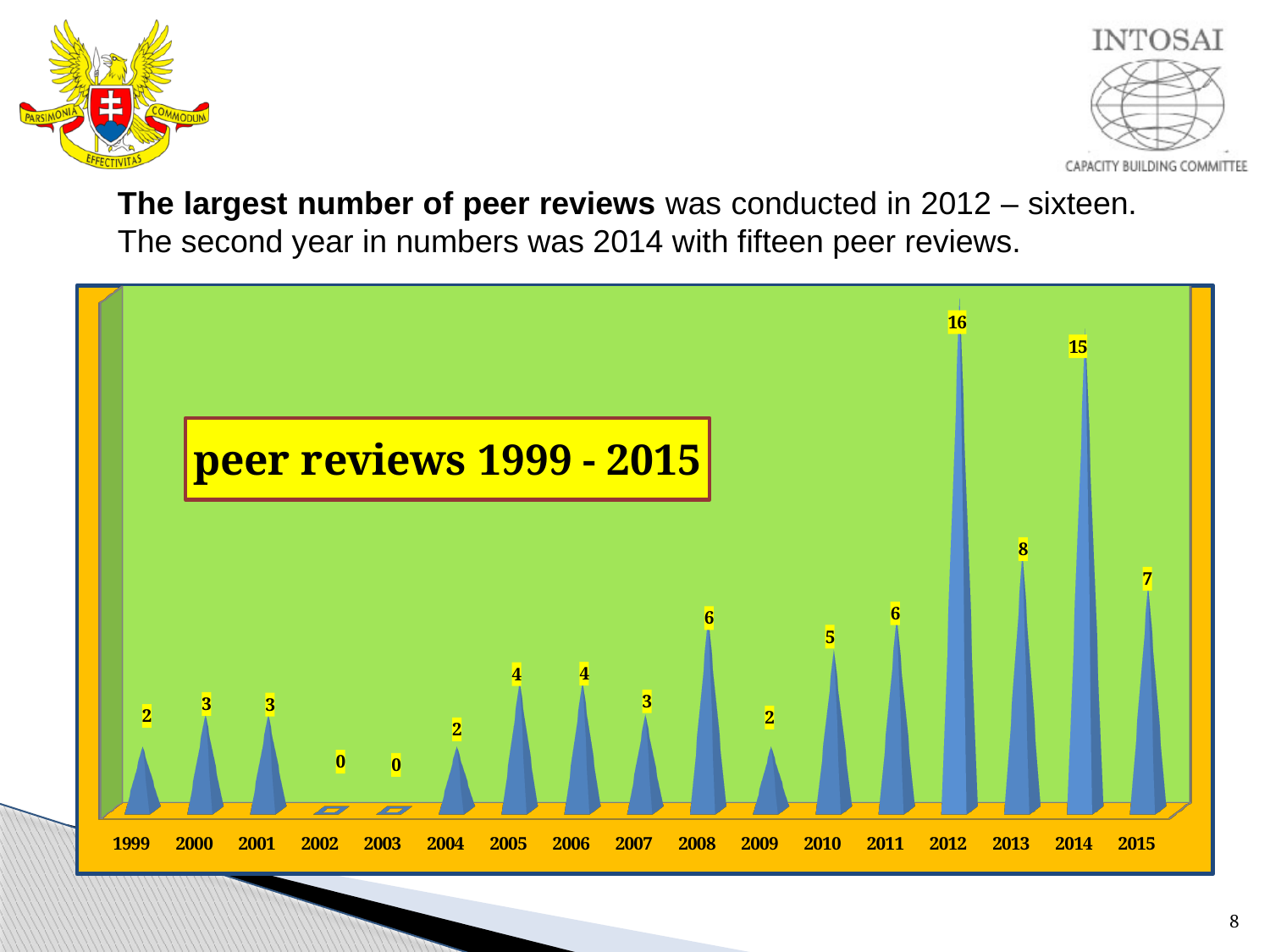
Which year had more peer reviews, 2010 or 2011? 2011 How many peer reviews were conducted in 2002? 0 What is the difference between the number of peer reviews in 2013 and 2015? 1 How many years are shown on the x axis of the chart? 17 Which year had more peer reviews, 2005 or 2009? 2005 How many peer reviews were conducted in 2008? 6 Which year has the highest number of peer reviews? 2012 How many peer reviews were conducted in 2001? 3 What kind of chart is shown on the slide? bar chart What is the difference between the number of peer reviews in 2012 and 2014? 1 How many peer reviews were conducted in 2012? 16 What is the title of the chart? peer reviews 1999 - 2015